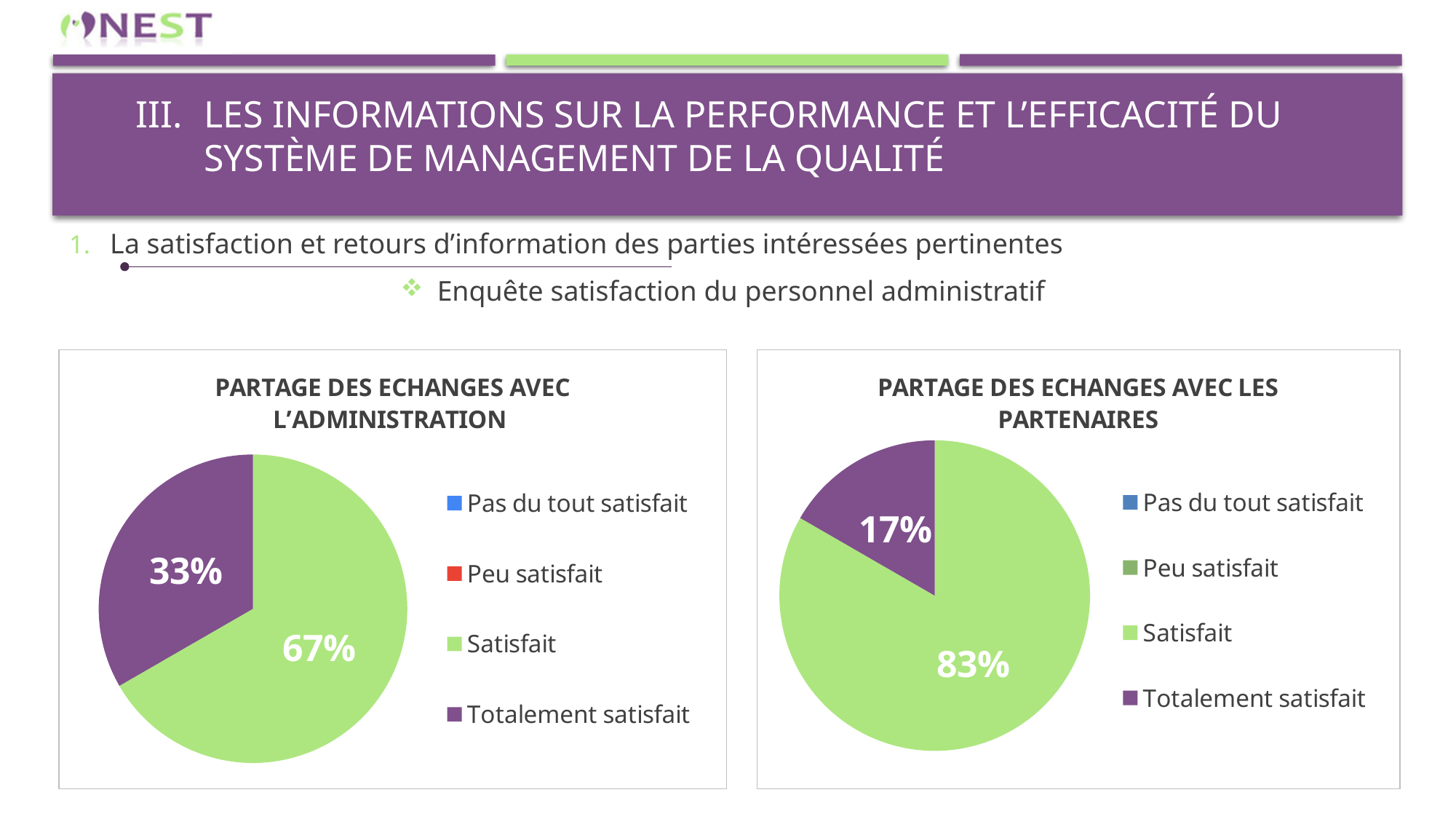
In the chart titled 'PARTAGE DES ECHANGES AVEC LES PARTENAIRES', what share is labelled for Totalement satisfait? 17% In the chart titled 'PARTAGE DES ECHANGES AVEC LES PARTENAIRES', what colour is the Satisfait slice? Green Which chart shows a larger share for Totalement satisfait, the one for L'ADMINISTRATION or the one for LES PARTENAIRES? L'ADMINISTRATION In the chart titled 'PARTAGE DES ECHANGES AVEC LES PARTENAIRES', what share is labelled for Satisfait? 83% In the chart titled 'PARTAGE DES ECHANGES AVEC L'ADMINISTRATION', which category has the largest slice? Satisfait In the chart titled 'PARTAGE DES ECHANGES AVEC L'ADMINISTRATION', what is the difference between the Satisfait and Totalement satisfait shares? 34% How many entries does the legend of the chart titled 'PARTAGE DES ECHANGES AVEC L'ADMINISTRATION' list? 4 In the chart titled 'PARTAGE DES ECHANGES AVEC LES PARTENAIRES', what is the difference between the Satisfait and Totalement satisfait shares? 66% In the chart titled 'PARTAGE DES ECHANGES AVEC L'ADMINISTRATION', what share is labelled for Totalement satisfait? 33% In the chart titled 'PARTAGE DES ECHANGES AVEC L'ADMINISTRATION', what share is labelled for Satisfait? 67% In the chart titled 'PARTAGE DES ECHANGES AVEC LES PARTENAIRES', which labelled category has the smallest slice? Totalement satisfait What type of chart is the chart titled 'PARTAGE DES ECHANGES AVEC LES PARTENAIRES'? Pie chart